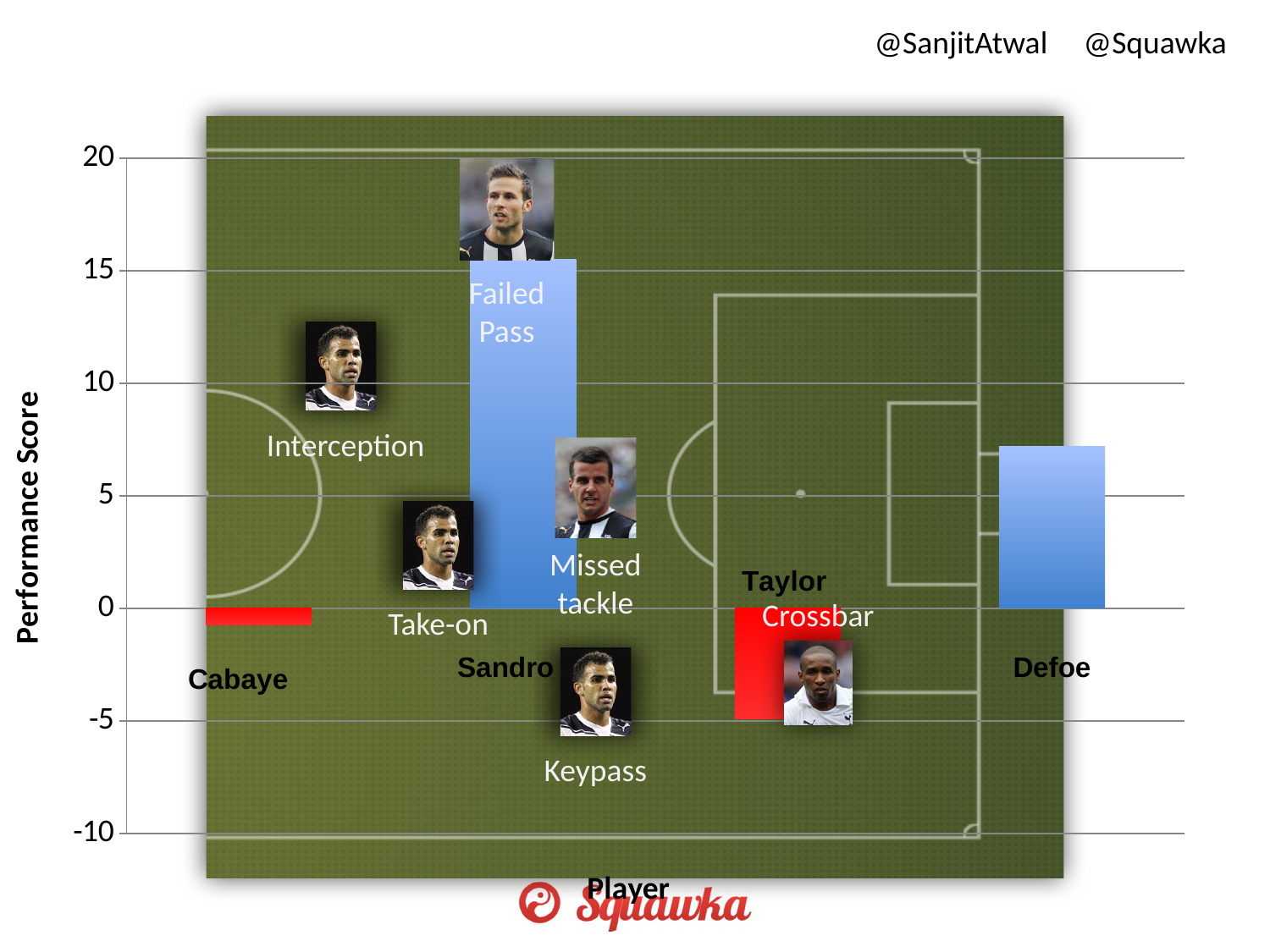
What kind of chart is shown on the slide? bar chart Is the performance score for Taylor greater or less than 0? less Is the performance score for Sandro greater or less than 10? greater Which player has the highest performance score? Sandro Which player has the lowest performance score? Taylor Is the performance score for Defoe greater or less than 10? less Which player has the higher performance score, Cabaye or Taylor? Cabaye Which player has the higher performance score, Sandro or Defoe? Sandro How many players have a negative performance score? 2 How many players are shown on the chart? 4 What is the title of the vertical axis? Performance Score